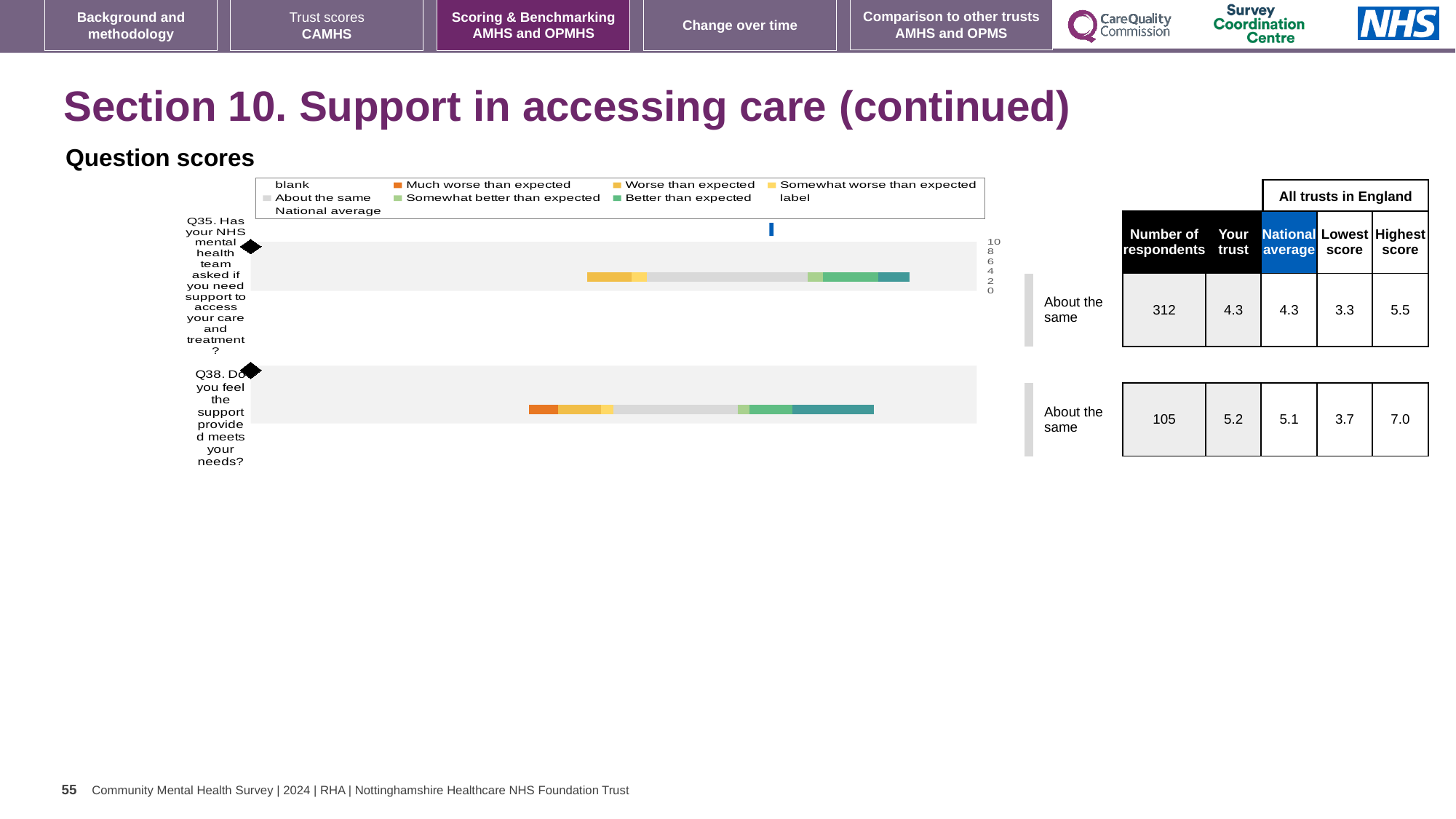
What benchmark category is shown for Q35? About the same What is the 'Your trust' score for Q38? 5.2 What kind of chart is shown under 'Question scores'? bar chart How many entries does the chart legend list? 9 Which question has the higher 'Your trust' score, Q35 or Q38? Q38 What is the difference between the highest and lowest scores for Q35? 2.2 What is the 'Your trust' score for Q35? 4.3 How many questions (categories) are plotted in the chart? 2 What is the difference between the highest and lowest scores for Q38? 3.3 What is the highest score among all trusts in England for Q38? 7.0 How many respondents answered Q35? 312 What is the national average for Q38? 5.1